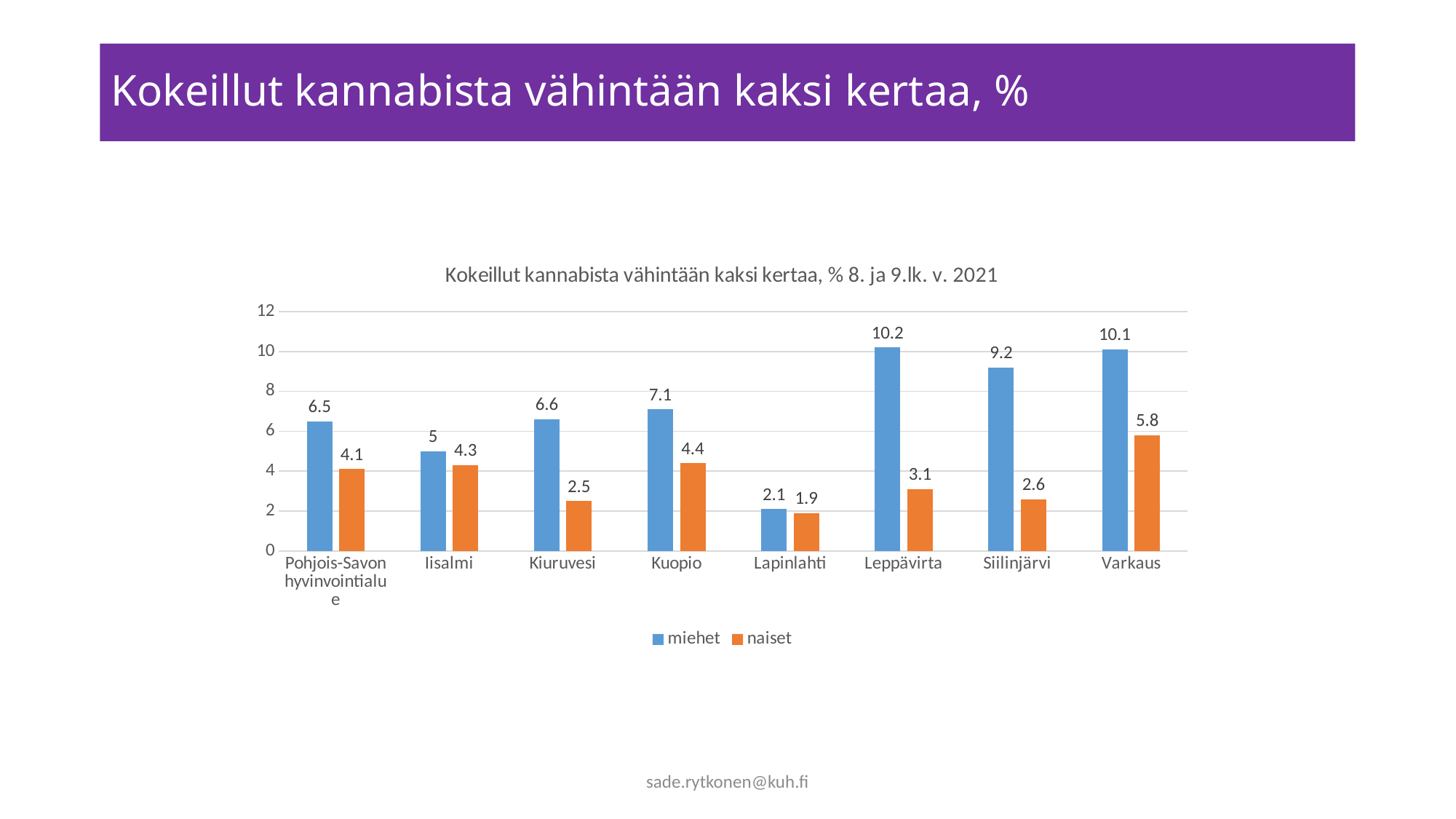
What is the value for miehet in Iisalmi? 5 How many categories are shown on the x axis? 8 What is the title of the chart? Kokeillut kannabista vähintään kaksi kertaa, % 8. ja 9.lk. v. 2021 Is the value for miehet in Varkaus greater or less than 8? greater What is the value for naiset in Kuopio? 4.4 Which is larger in Kiuruvesi, the miehet value or the naiset value? miehet What is the difference between the miehet and naiset values in Siilinjärvi? 6.6 What is the value for miehet in Leppävirta? 10.2 How many series does the legend list? 2 Which category has the highest value for naiset? Varkaus What kind of chart is shown on the slide? bar chart Which category has the lowest value for miehet? Lapinlahti